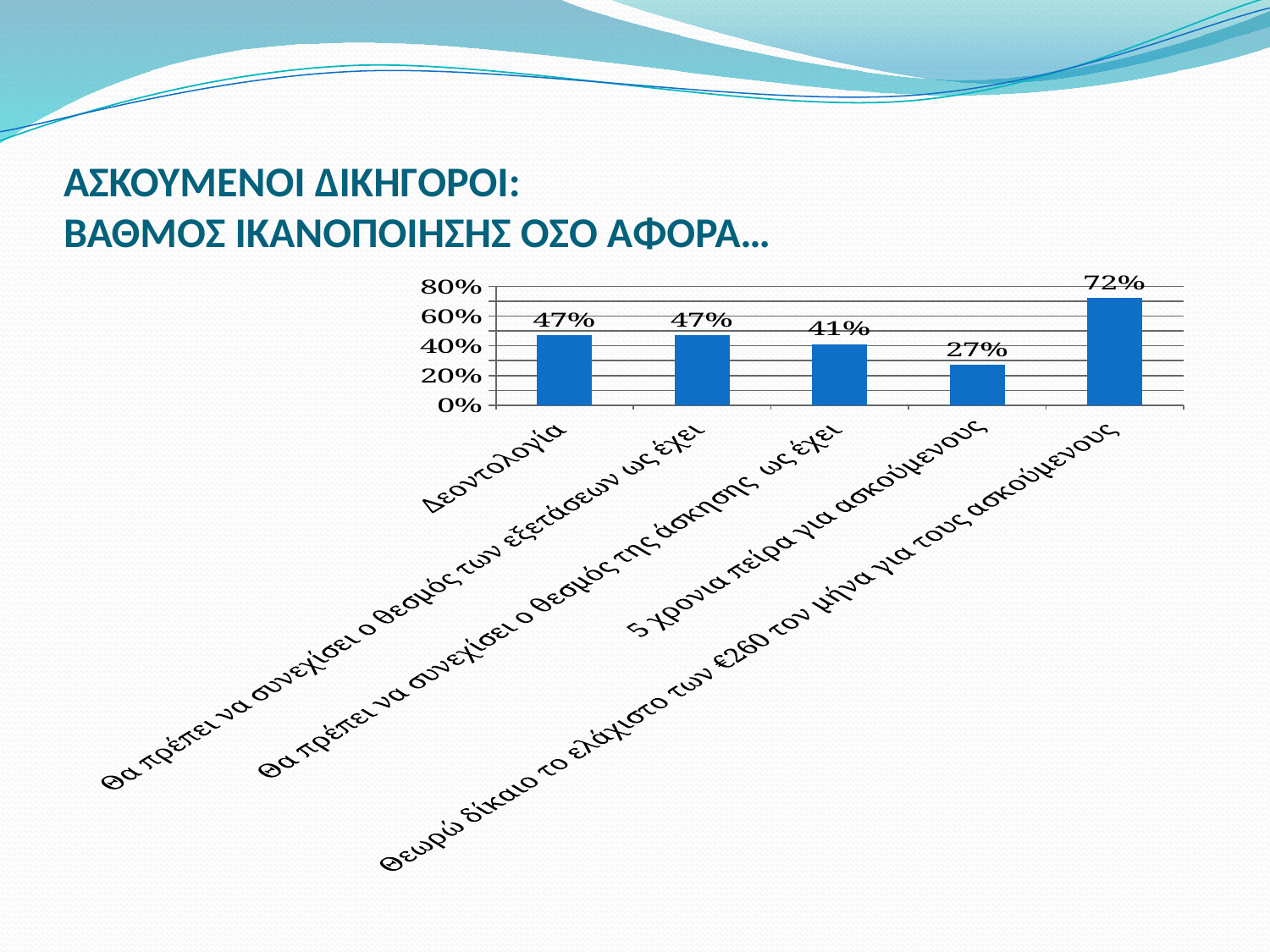
What kind of chart is shown on the slide? Bar chart Which category has the highest value? Θεωρώ δίκαιο το ελάχιστο των €260 τον μήνα για τους ασκούμενους Which is larger: the value for "Θα πρέπει να συνεχίσει ο θεσμός των εξετάσεων ως έχει" or the value for "5 χρόνια πείρα για ασκούμενους"? Θα πρέπει να συνεχίσει ο θεσμός των εξετάσεων ως έχει How many categories are shown in the chart? 5 What is the value for "Θεωρώ δίκαιο το ελάχιστο των €260 τον μήνα για τους ασκούμενους"? 72% What is the difference between the value for "Θεωρώ δίκαιο το ελάχιστο των €260 τον μήνα για τους ασκούμενους" and the value for "5 χρόνια πείρα για ασκούμενους"? 45% What is the value for "Θα πρέπει να συνεχίσει ο θεσμός της άσκησης ως έχει"? 41% What is the value for Δεοντολογία? 47% What is the maximum value shown on the vertical axis? 80% What is the value for "5 χρόνια πείρα για ασκούμενους"? 27% Which category has the lowest value? 5 χρόνια πείρα για ασκούμενους What is the difference between the value for Δεοντολογία and the value for "Θα πρέπει να συνεχίσει ο θεσμός της άσκησης ως έχει"? 6%